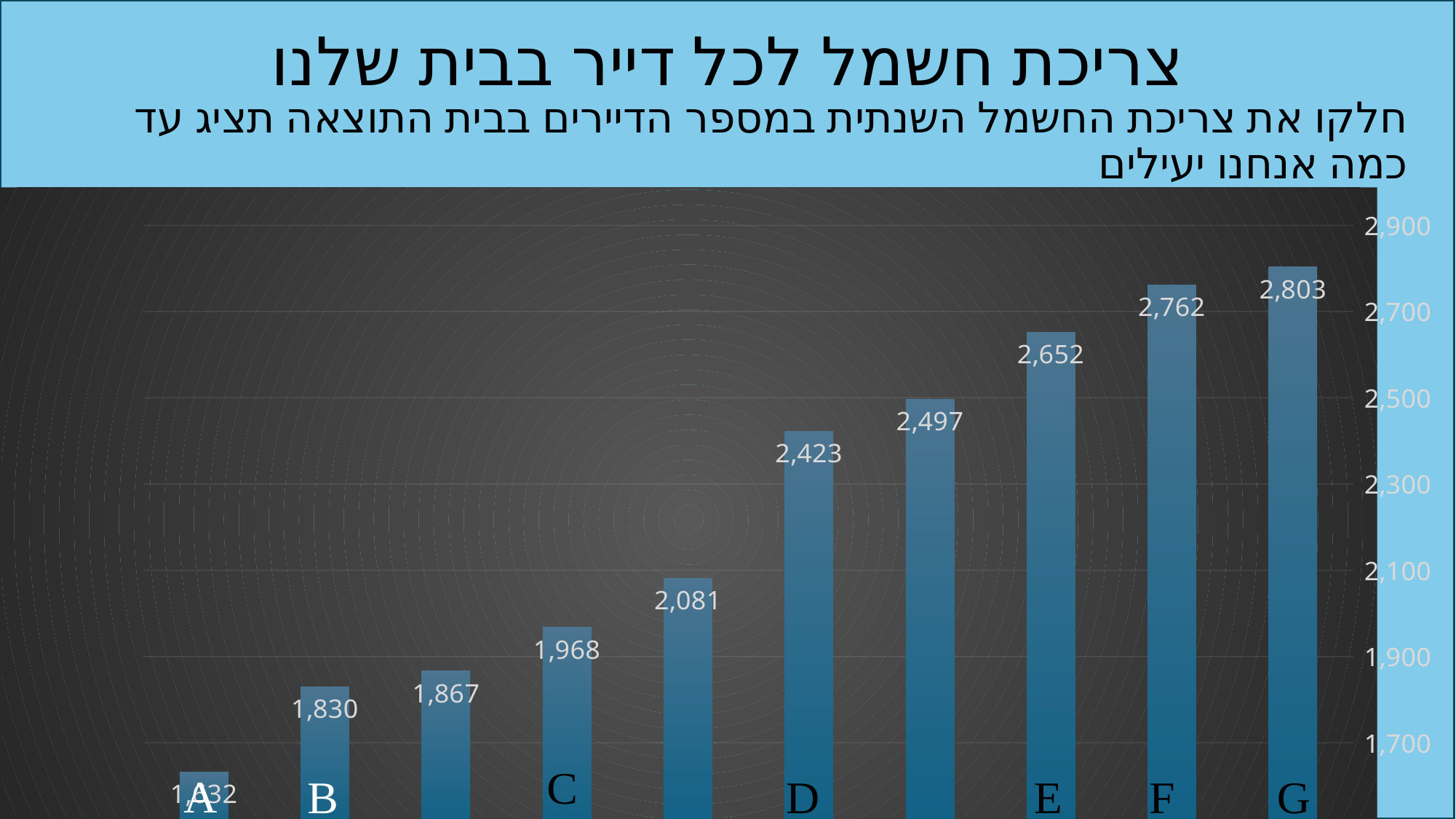
What is the value for D? 2,423 What is the value for B? 1,830 What is the value for G? 2,803 Is the value for A greater or less than 1,700? less What is the value for C? 1,968 Which labeled category has the lowest value? A What is the difference between the values for G and F? 41 Which labeled category has the highest value? G What is the value for E? 2,652 Which is larger, the value for C or the value for B? C Do the bar values rise or fall from left to right? rise What kind of chart is shown on the slide? bar chart